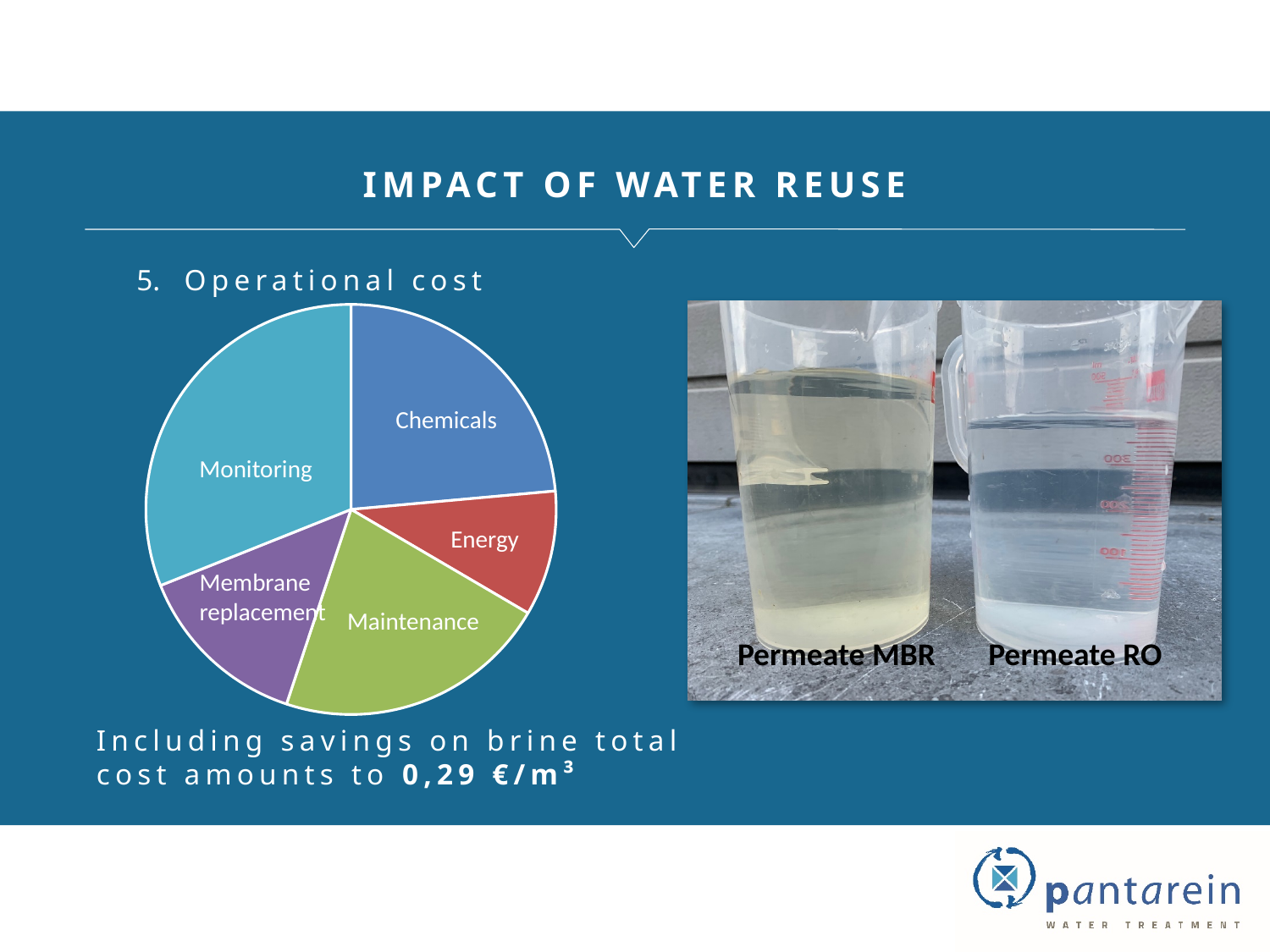
In the operational cost pie chart, which slice is larger: Monitoring or Membrane replacement? Monitoring In the operational cost pie chart, which slice is larger: Chemicals or Energy? Chemicals What colour is the Energy slice in the operational cost pie chart? Red What colour is the Maintenance slice in the operational cost pie chart? Green Which category has the largest slice in the operational cost pie chart? Monitoring Which category has the smallest slice in the operational cost pie chart? Energy How many slices does the operational cost pie chart have? 5 In the operational cost pie chart, which slice is larger: Maintenance or Energy? Maintenance What kind of chart is shown under "5. Operational cost"? Pie chart